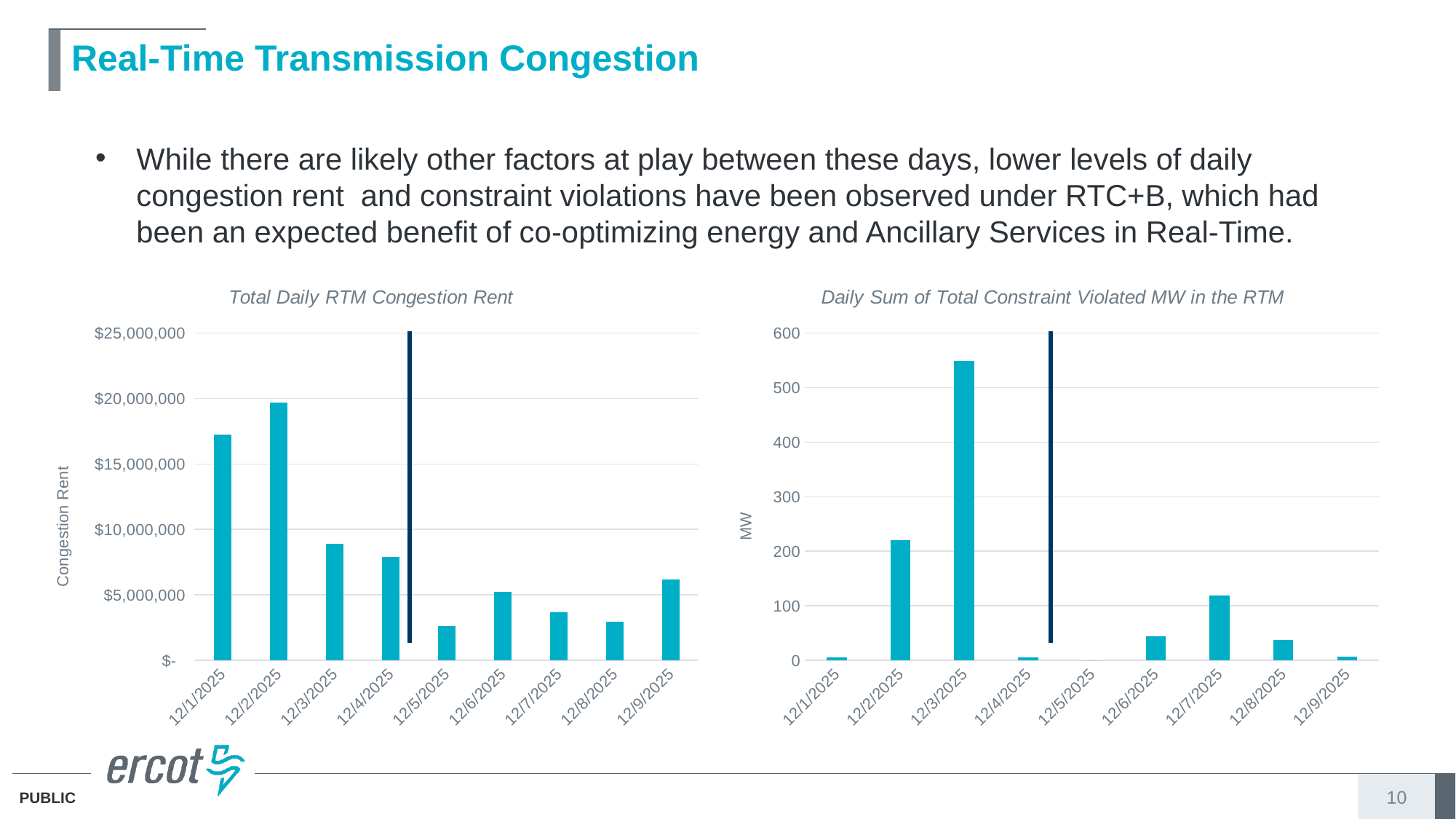
In the 'Total Daily RTM Congestion Rent' chart, is the value for 12/5/2025 greater or less than $5,000,000? less What type of chart is the 'Total Daily RTM Congestion Rent' chart? bar chart What is the y-axis label of the 'Daily Sum of Total Constraint Violated MW in the RTM' chart? MW In the 'Total Daily RTM Congestion Rent' chart, which is larger, the value for 12/1/2025 or 12/3/2025? 12/1/2025 In the 'Total Daily RTM Congestion Rent' chart, is the value for 12/2/2025 greater or less than $15,000,000? greater In the 'Daily Sum of Total Constraint Violated MW in the RTM' chart, is the value for 12/3/2025 greater or less than 500? greater In the 'Total Daily RTM Congestion Rent' chart, which date has the highest congestion rent? 12/2/2025 How many dates are shown on the x axis of the 'Total Daily RTM Congestion Rent' chart? 9 In the 'Total Daily RTM Congestion Rent' chart, which date has the lowest congestion rent? 12/5/2025 In the 'Daily Sum of Total Constraint Violated MW in the RTM' chart, which is larger, the value for 12/2/2025 or 12/7/2025? 12/2/2025 In the 'Daily Sum of Total Constraint Violated MW in the RTM' chart, which date has the highest value? 12/3/2025